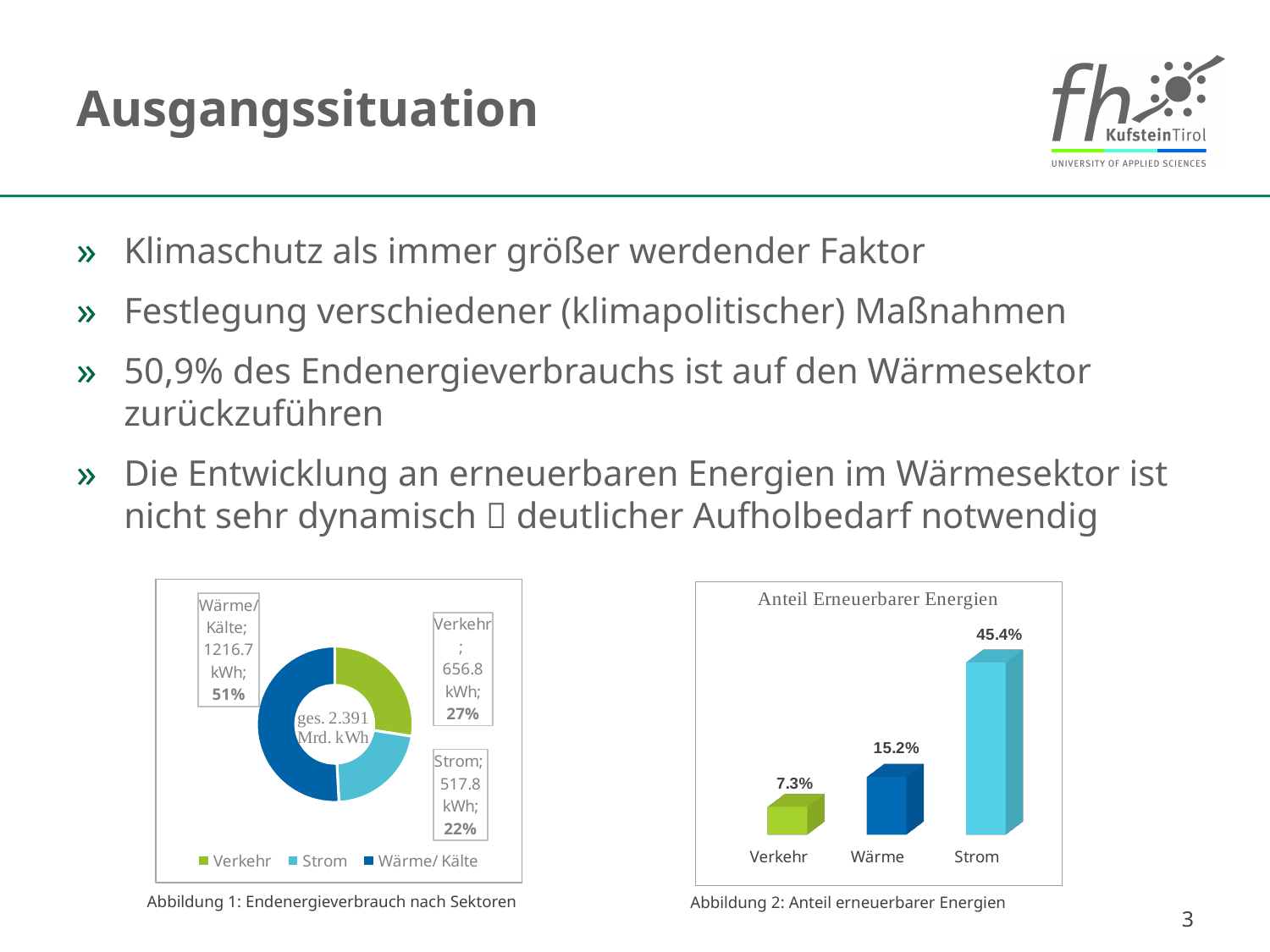
In the chart titled 'Anteil Erneuerbarer Energien', what is the difference between the values for Strom and Wärme? 30.2% In the chart titled 'Anteil Erneuerbarer Energien', how many categories are shown? 3 In the chart on the left (Abbildung 1), what share of the total does Wärme/ Kälte account for? 51% In the chart on the left (Abbildung 1), what total is shown in the centre of the doughnut? ges. 2.391 Mrd. kWh In the chart titled 'Anteil Erneuerbarer Energien', what is the value for Verkehr? 7.3% In the chart titled 'Anteil Erneuerbarer Energien', which category has the highest value? Strom In the chart on the left (Abbildung 1), what is the value shown for Strom? 517.8 kWh What kind of chart is the chart titled 'Anteil Erneuerbarer Energien'? Bar chart In the chart on the left (Abbildung 1), which is larger: Verkehr or Strom? Verkehr In the chart titled 'Anteil Erneuerbarer Energien', which category has the lowest value? Verkehr In the chart on the left (Abbildung 1), which sector has the largest share? Wärme/ Kälte In the chart titled 'Anteil Erneuerbarer Energien', what is the value for Strom? 45.4%